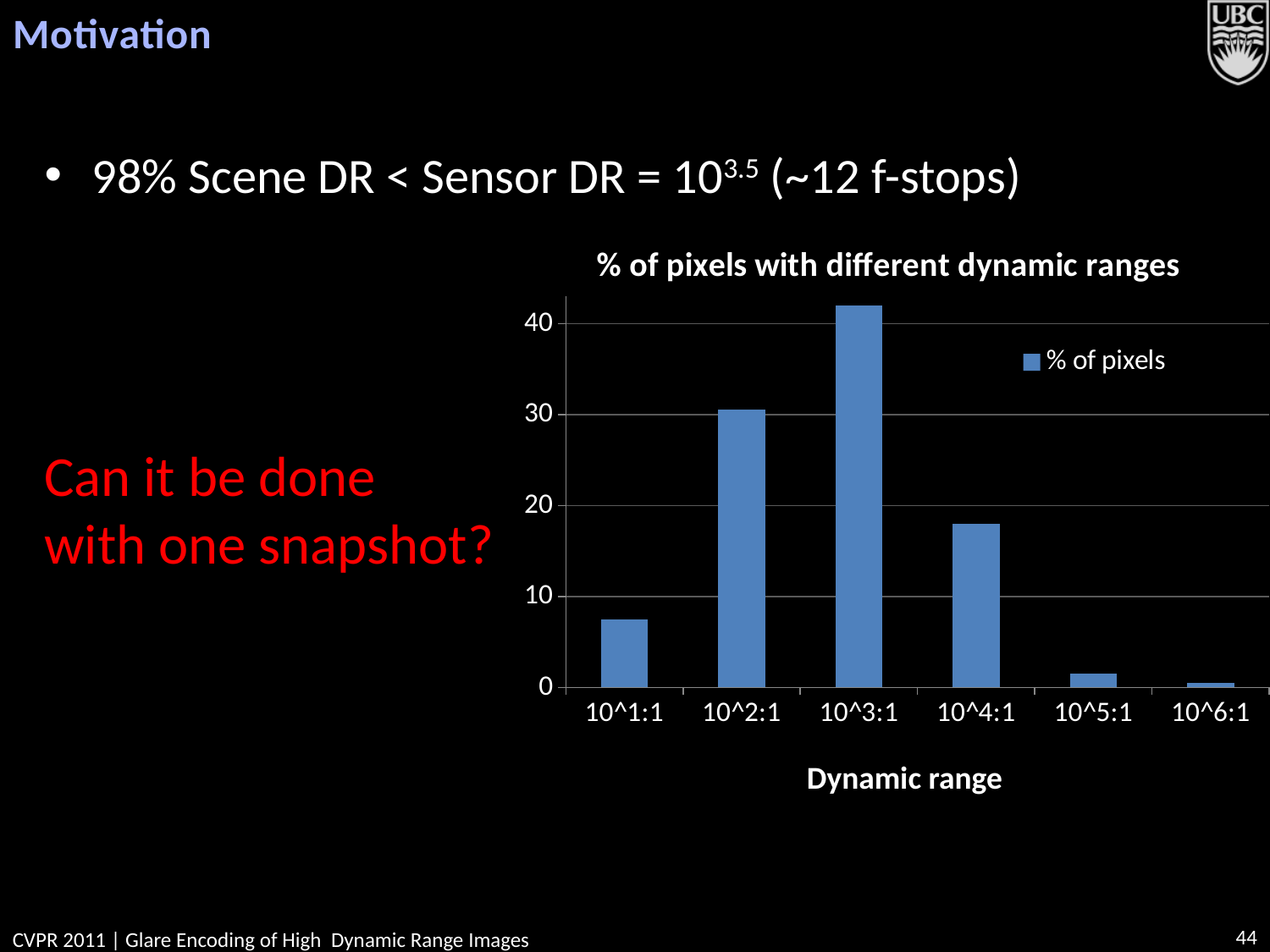
Which dynamic range category has the lowest % of pixels? 10^6:1 What is the title of the chart? % of pixels with different dynamic ranges How many dynamic range categories are shown on the x axis? 6 Is the % of pixels for 10^4:1 greater or less than 20? less Is the % of pixels for 10^3:1 greater or less than 40? greater Is the % of pixels for 10^2:1 greater or less than 20? greater Which has a larger % of pixels, 10^2:1 or 10^4:1? 10^2:1 What is the x-axis title of the chart? Dynamic range How many series does the legend list? 1 What kind of chart is shown on the slide? bar chart Which dynamic range category has the highest % of pixels? 10^3:1